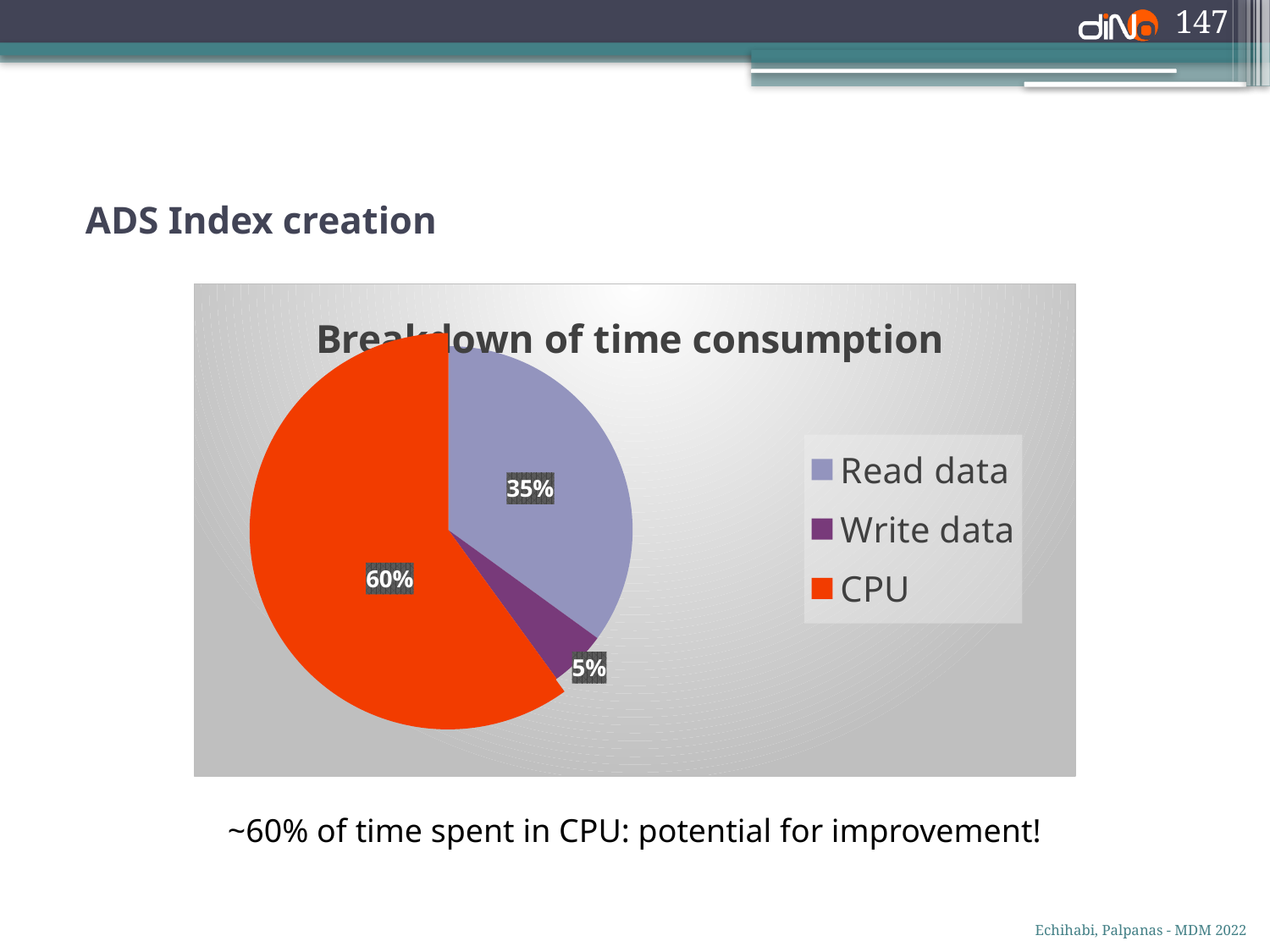
Which is larger, the share for Read data or the share for Write data? Read data What share of time consumption is attributed to Write data? 5% What is the difference in percentage points between the CPU share and the Read data share? 25 How many slices does the pie chart have? 3 What is the title of the chart? Breakdown of time consumption What colour is the CPU slice in the pie chart? orange-red What share of time consumption is attributed to CPU? 60% How many entries does the legend list? 3 Which category accounts for the smallest share of time consumption? Write data What kind of chart is shown on the slide? pie chart Which category accounts for the largest share of time consumption? CPU What share of time consumption is attributed to Read data? 35%